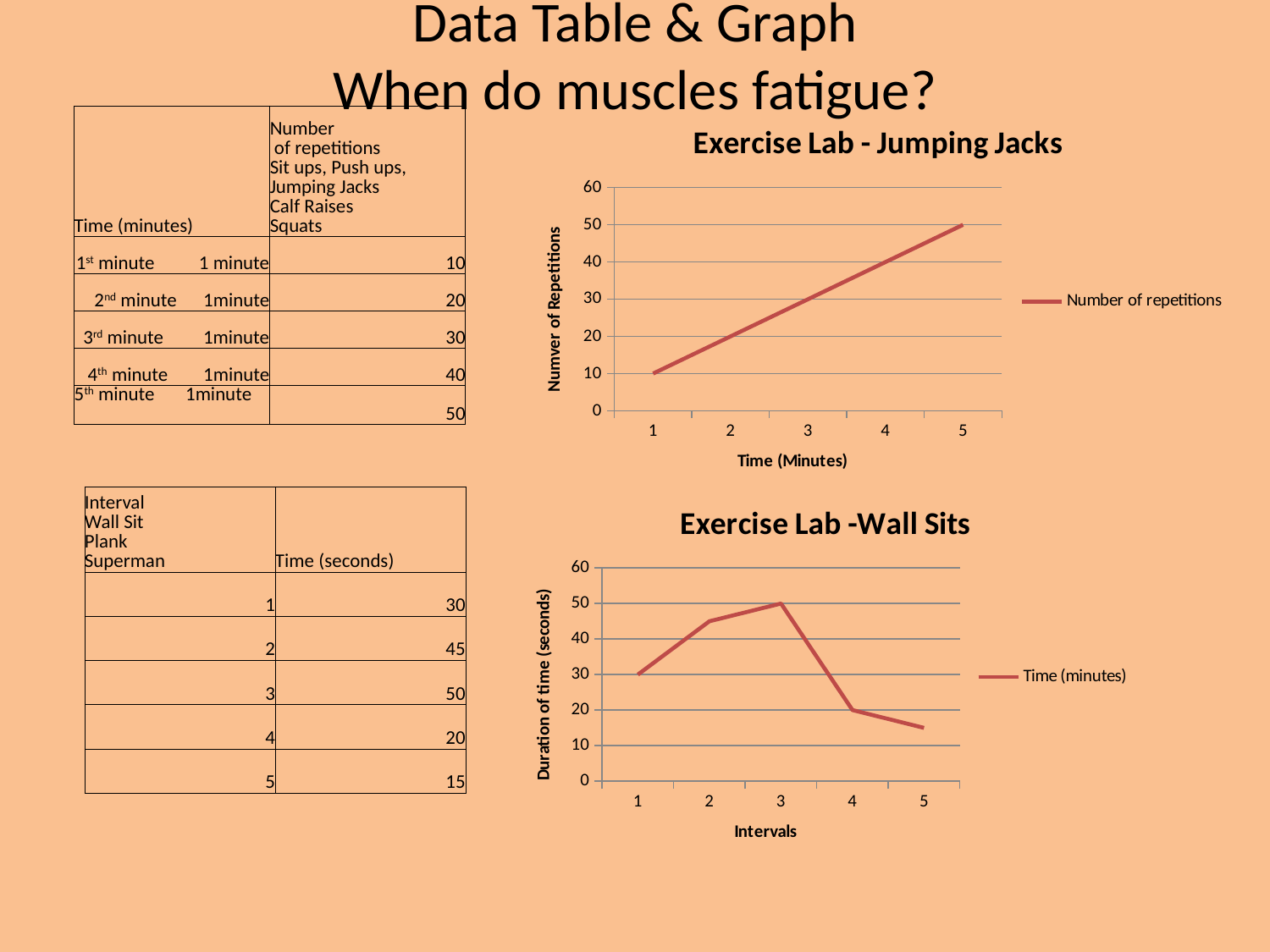
In the 'Exercise Lab - Jumping Jacks' chart, what is the difference in repetitions between minute 5 and minute 1? 40 How many data points are plotted in the 'Exercise Lab - Jumping Jacks' chart? 5 In the 'Exercise Lab -Wall Sits' chart, what is the duration at interval 3? 50 What is the label of the y axis in the 'Exercise Lab - Jumping Jacks' chart? Numver of Repetitions In the 'Exercise Lab -Wall Sits' chart, which interval has the lowest duration? 5 In the 'Exercise Lab - Jumping Jacks' chart, what is the number of repetitions at minute 1? 10 In the 'Exercise Lab -Wall Sits' chart, which is larger: the value at interval 1 or the value at interval 4? interval 1 In the 'Exercise Lab -Wall Sits' chart, which interval has the highest duration? 3 In the 'Exercise Lab - Jumping Jacks' chart, do the values rise or fall as time increases from minute 1 to minute 5? rise In the 'Exercise Lab -Wall Sits' chart, is the value for interval 2 greater or less than 40? greater What kind of chart is the 'Exercise Lab - Jumping Jacks' chart? line chart In the 'Exercise Lab - Jumping Jacks' chart, what is the number of repetitions at minute 5? 50